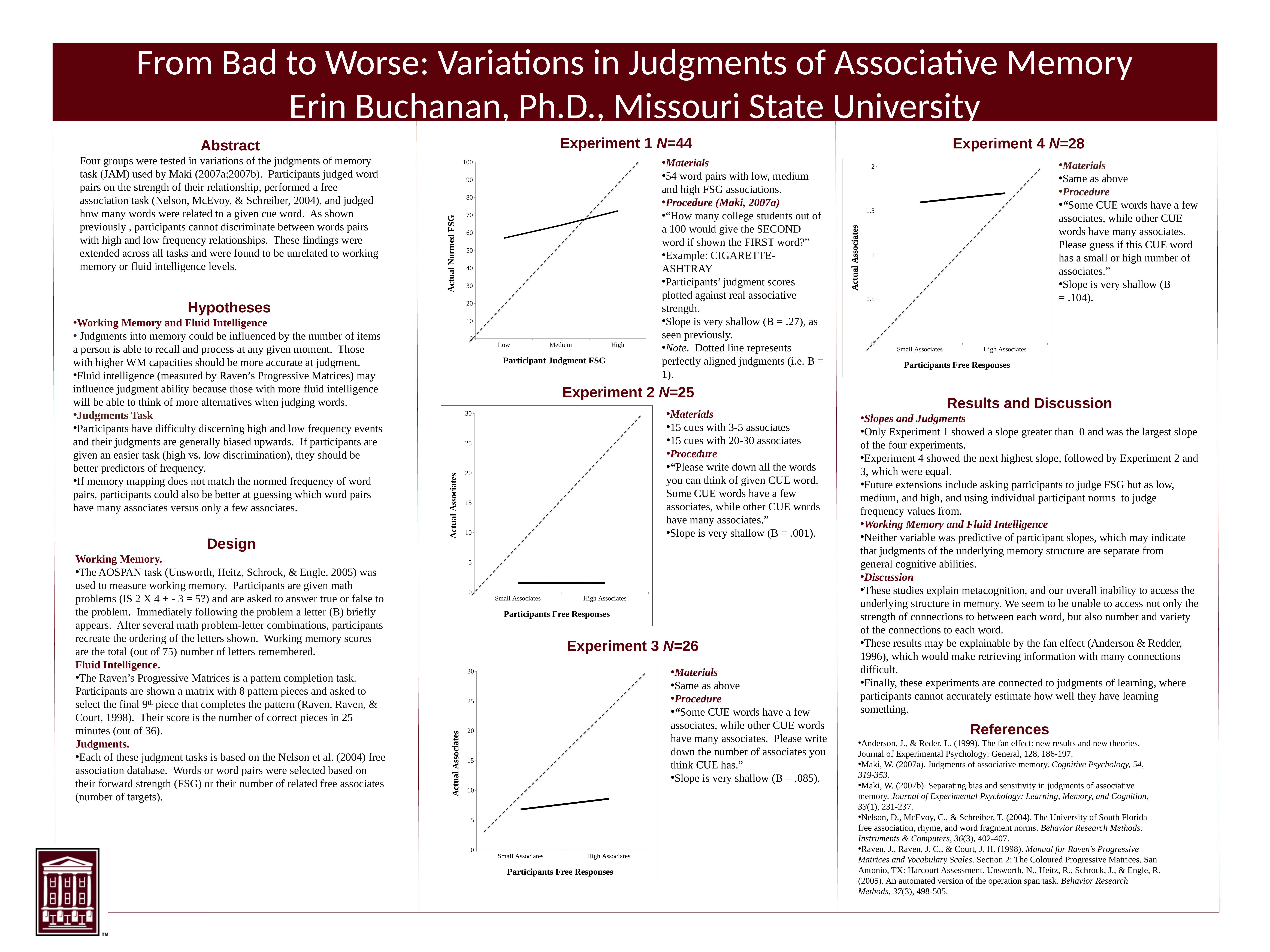
On the Experiment 1 chart, is the solid line's value for High greater or less than 80? less On the Experiment 1 chart, does the solid line rise or fall from Low to High? rise On the Experiment 1 chart, is the solid line's value for Low greater or less than 50? greater On the Experiment 2 chart, how many categories are on the x axis? 2 On the Experiment 3 chart, is the solid line's value for High Associates greater or less than 5? greater On the Experiment 1 chart, how many categories are on the x axis? 3 On the Experiment 1 chart, what kind of chart is shown? line chart On the Experiment 1 chart, what is the y-axis title? Actual Normed FSG On the Experiment 4 chart, what is the x-axis title? Participants Free Responses